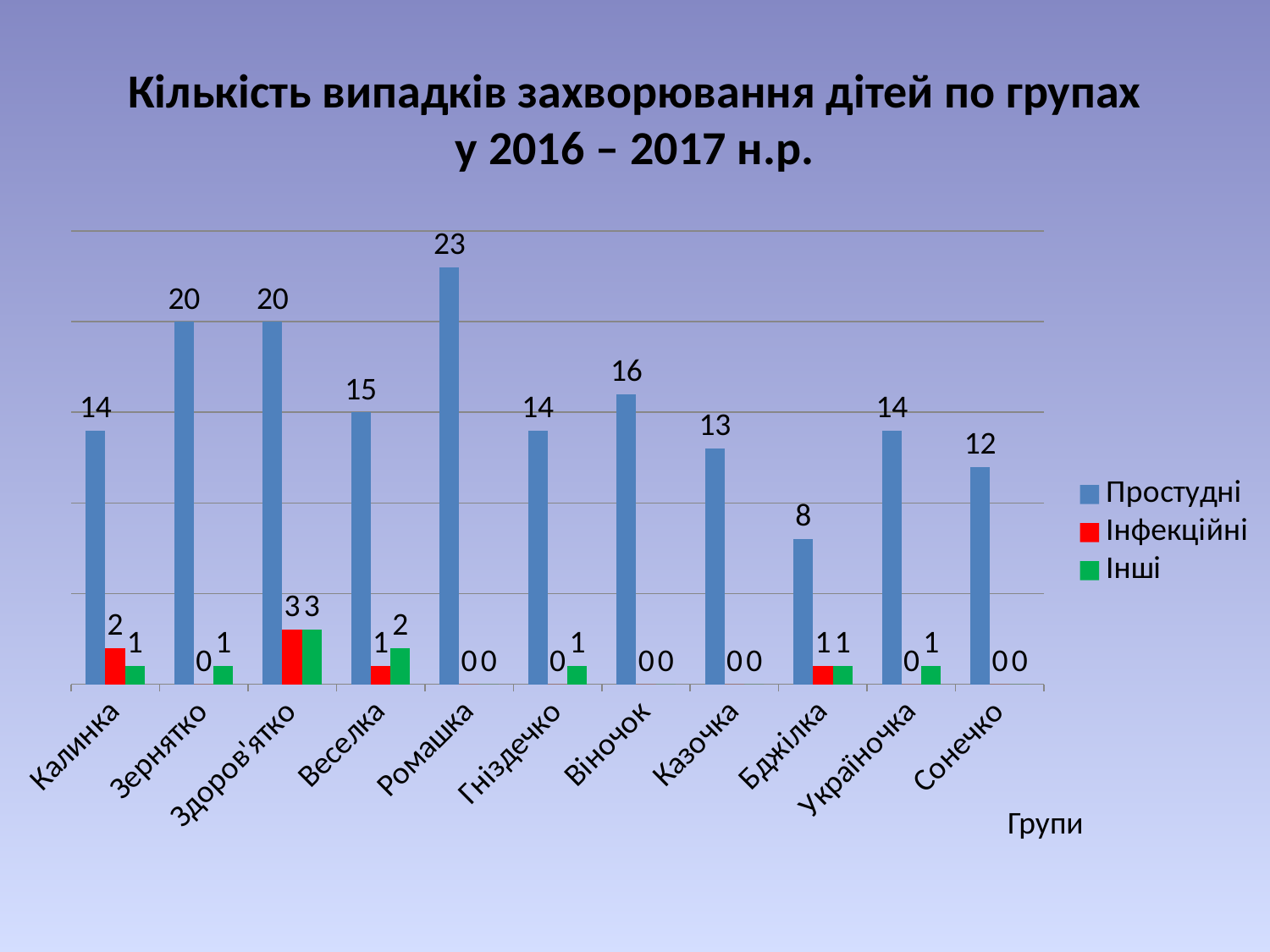
How many series does the legend list? 3 Which group has the highest value for Простудні? Ромашка Which group has the lowest value for Простудні? Бджілка How many groups are shown on the x axis? 11 What is the x-axis label of the chart? Групи What kind of chart is shown on the slide? bar chart What is the difference between the Простудні values for Ромашка and Бджілка? 15 Which is larger, the Простудні value for Віночок or for Казочка? Віночок What is the value for Простудні in the Ромашка group? 23 What is the value for Інфекційні in the Здоров'ятко group? 3 What is the total of the three values for the Здоров'ятко group? 26 What is the value for Інші in the Веселка group? 2